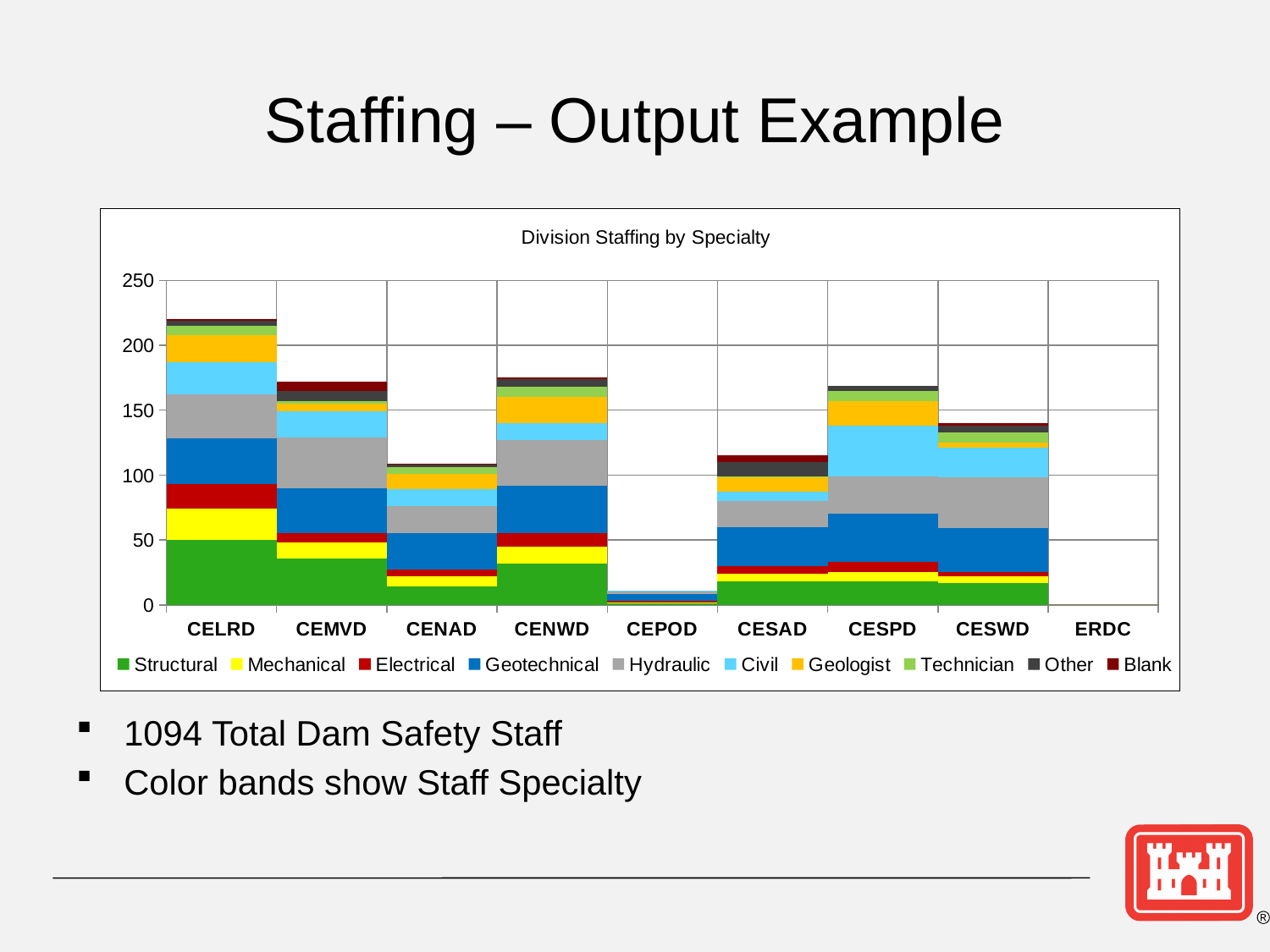
Is the total bar height for CELRD greater or less than 200? greater What kind of chart is shown on the slide? Stacked bar chart Is the total bar height for CEPOD greater or less than 50? less Is the total bar height for CENWD greater or less than 150? greater Which division has the tallest stacked bar in the chart? CELRD What is the title of the chart? Division Staffing by Specialty Which division has a taller stacked bar, CESPD or CESWD? CESPD How many specialties does the chart legend list? 10 How many divisions (categories) are shown on the x axis of the chart? 9 Which division has the smallest stacked bar in the chart? ERDC Which specialty is shown in green at the bottom of each stacked bar? Structural